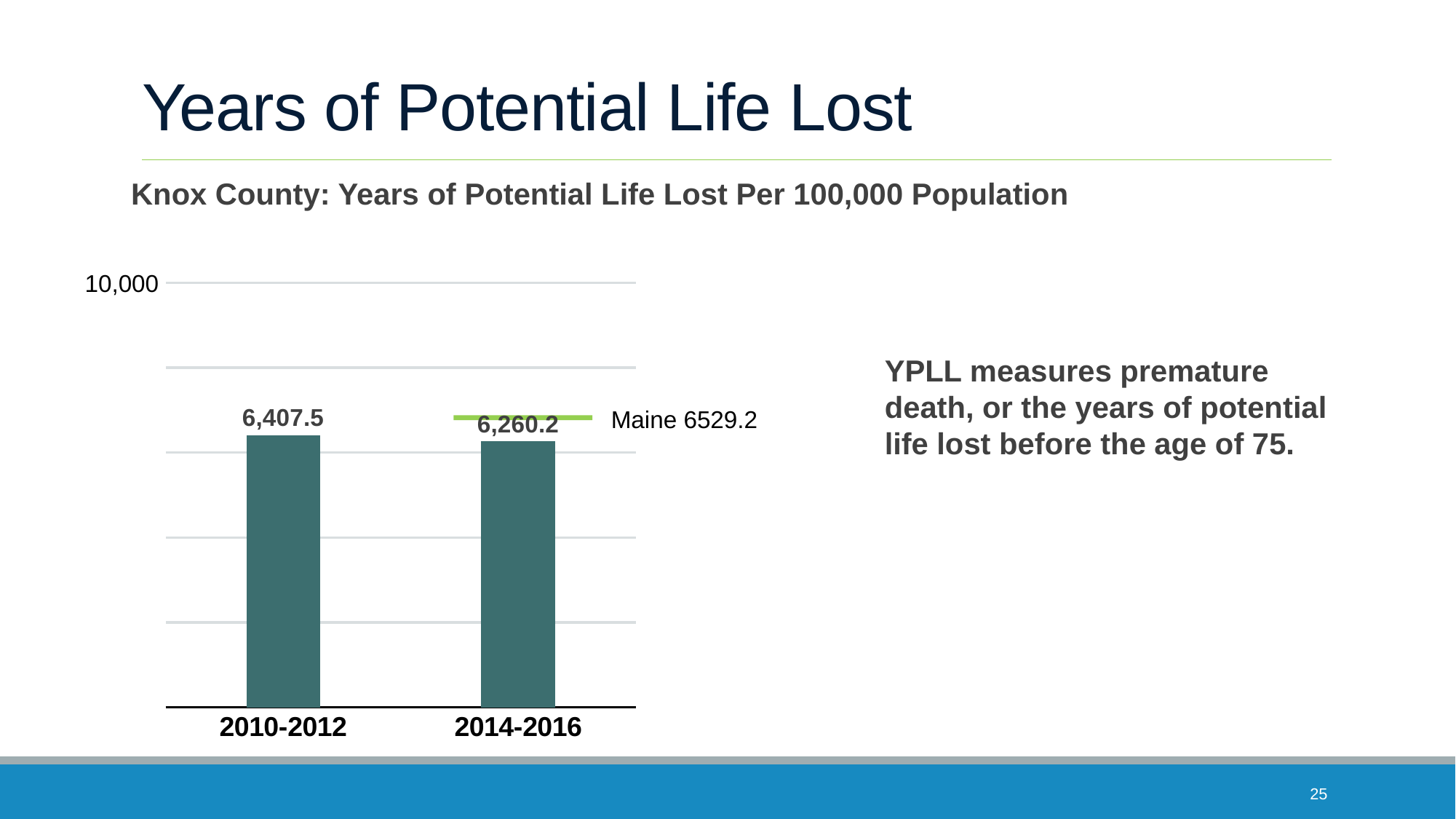
What is the value for 2014-2016? 6,260.2 What kind of chart is shown? bar chart Is the value for 2014-2016 greater or less than 10,000? less How many periods are shown on the x axis? 2 What is the title of the chart? Knox County: Years of Potential Life Lost Per 100,000 Population What is the difference between the 2010-2012 and 2014-2016 values? 147.3 What is the value for 2010-2012? 6,407.5 Which period has the lower value? 2014-2016 Is the value for 2010-2012 larger or smaller than the value for 2014-2016? larger Which period has the higher value? 2010-2012 Do the values rise or fall from 2010-2012 to 2014-2016? fall What Maine value is marked by the green reference line? 6529.2